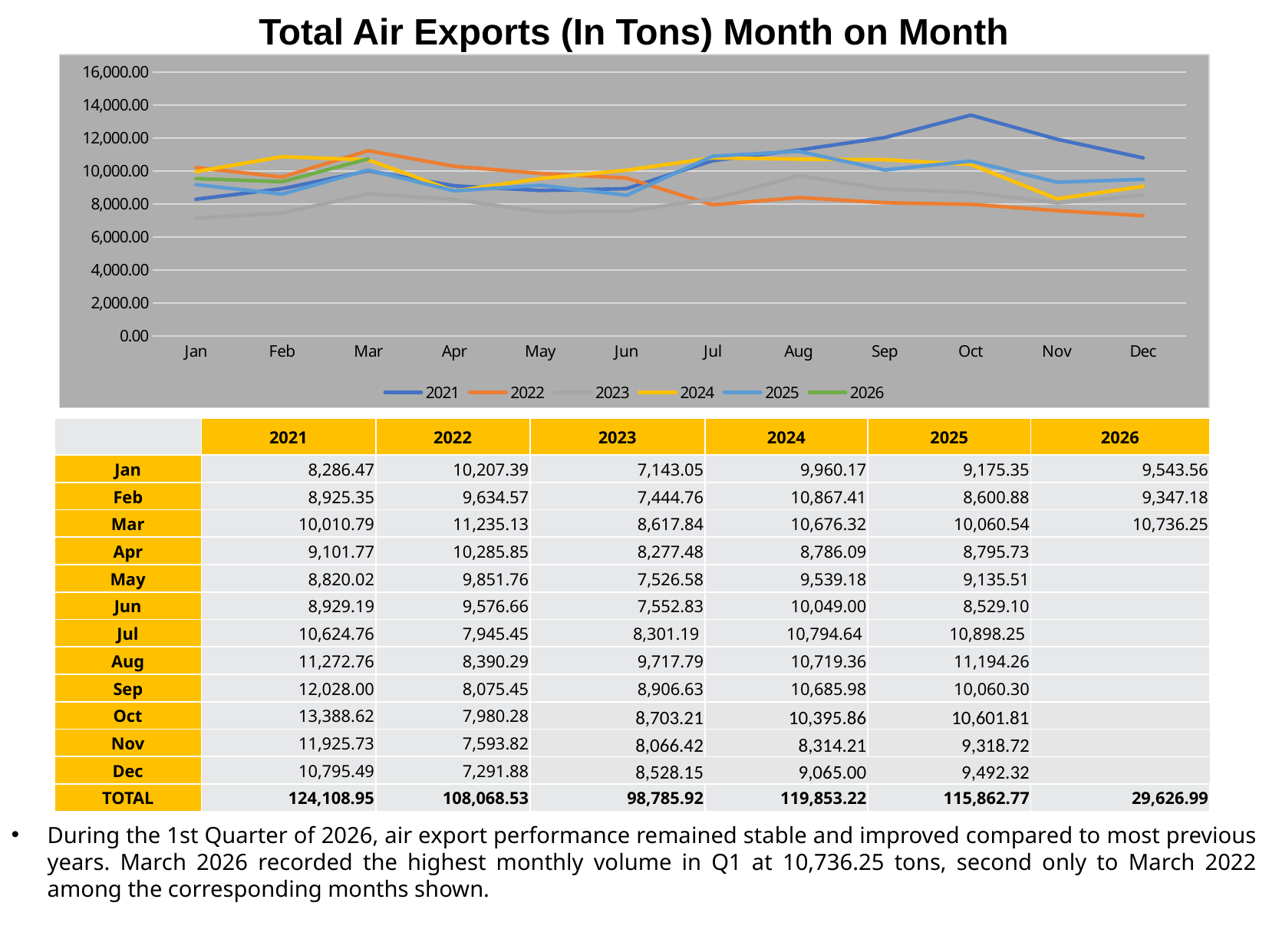
What is the difference between the March values for 2022 and 2026? 498.88 What is the value for 2023 in January? 7,143.05 In which month does the 2021 series reach its highest value? Oct What is the value for 2021 in October? 13,388.62 Does the 2022 series rise or fall from July to December? fall What kind of chart is shown on the slide? line chart What is the value for 2026 in March? 10,736.25 Is the value for 2021 in October greater or less than 12,000.00? greater How many months are plotted along the x axis of the chart? 12 How many series does the chart legend list? 6 In which month does the 2023 series have its lowest value? Jan Which is larger, the January value for 2022 or the January value for 2023? 2022